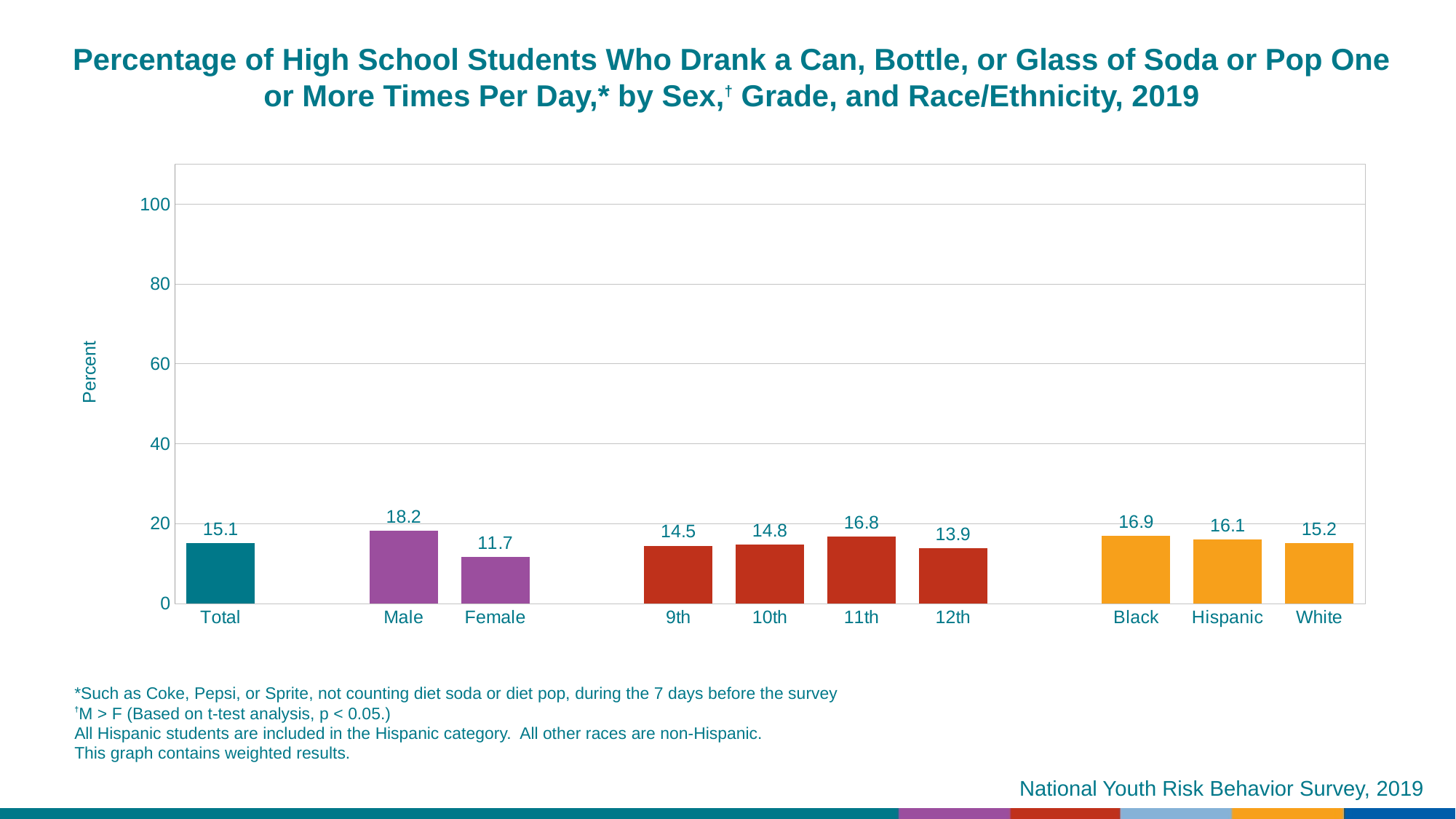
What is the value for Total? 15.1 Which category has the highest value? Male Which category has the lowest value? Female Is the value for 12th grade greater or less than 20? less Which is larger, the value for Black or the value for White? Black What is the label of the y axis? Percent What kind of chart is shown? bar chart What is the value for 11th grade? 16.8 How many categories are shown on the x axis? 10 What is the difference between the values for Male and Female? 6.5 What is the value for Hispanic? 16.1 What is the value for Female? 11.7